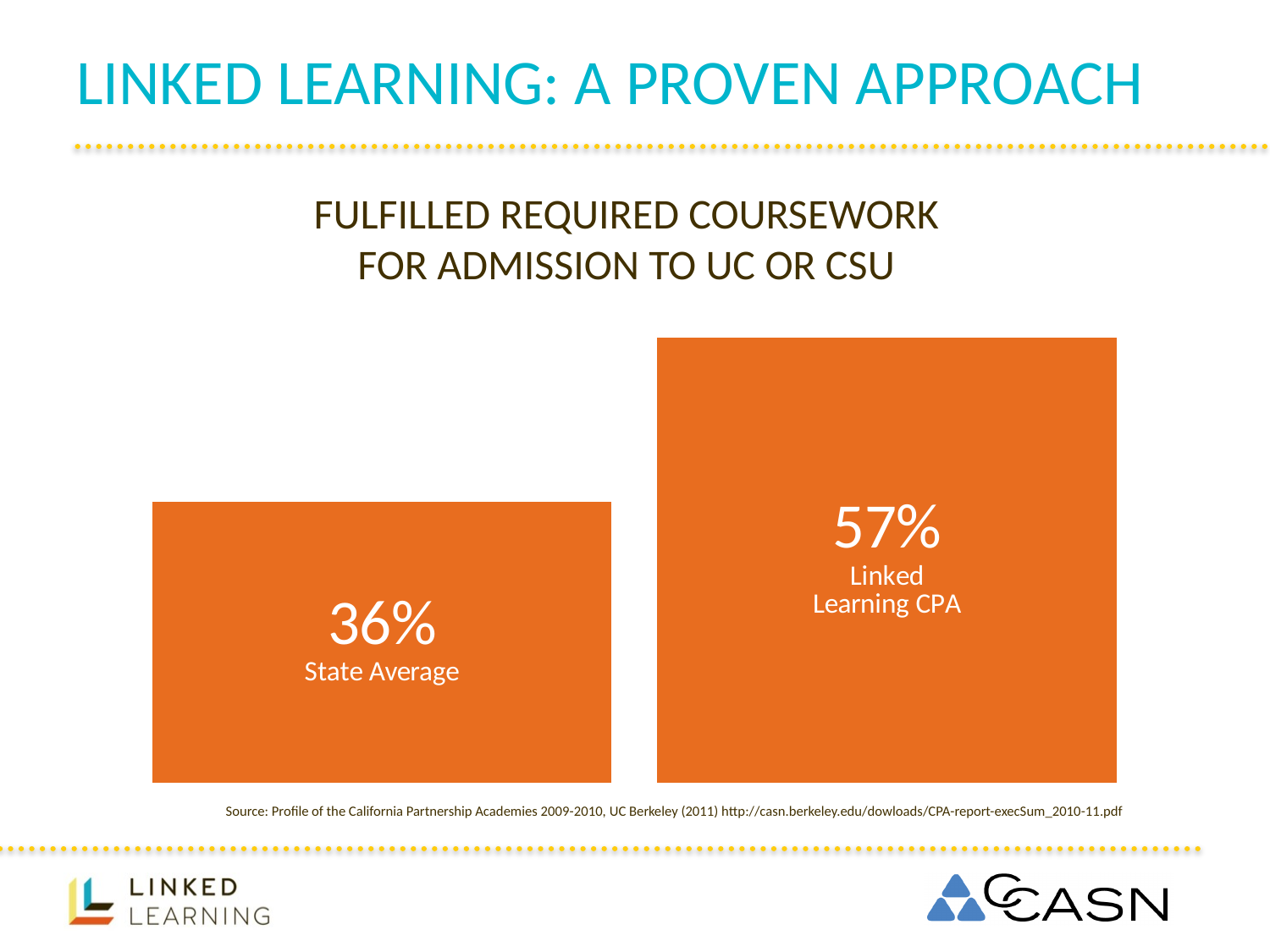
Which category has the higher value, State Average or Linked Learning CPA? Linked Learning CPA What is the title of the chart? Fulfilled Required Coursework for Admission to UC or CSU What kind of chart is shown on the slide? bar chart What is the difference in percentage points between Linked Learning CPA and the State Average? 21 percentage points What percentage of students fulfilled required coursework for admission to UC or CSU for the State Average? 36% What colour are the bars on the chart? orange What percentage of students fulfilled required coursework for admission to UC or CSU for Linked Learning CPA? 57% Is the value for Linked Learning CPA larger or smaller than the value for State Average? larger Which category has the lower value on the chart? State Average How many categories are shown on the chart? 2